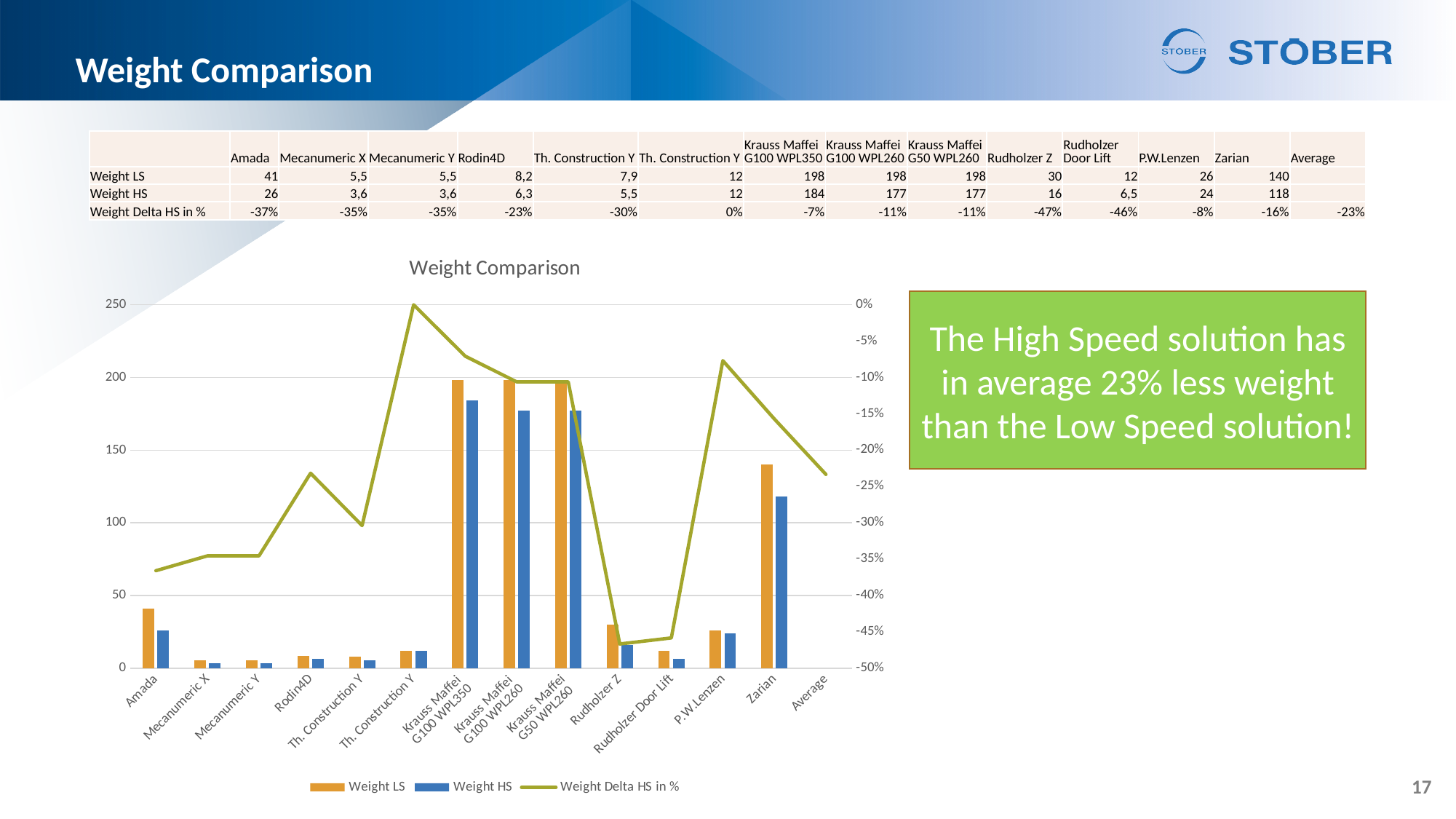
What is the Average value of Weight Delta HS in %? -23% Which is larger, the Weight LS for Amada or the Weight LS for Zarian? Zarian What kind of chart is shown on the slide? bar chart with a line What is the Weight Delta HS in % for Rudholzer Z? -47% How many categories are shown on the x axis of the chart? 14 How many series does the chart legend list? 3 What is the difference between Weight LS and Weight HS for Zarian? 22 What is the Weight HS value for Zarian? 118 What is the Weight LS value for Amada? 41 Is the Weight LS value for Rudholzer Z greater or less than 50? less Which category has the highest Weight Delta HS in %? Th. Construction Y What is the difference between Weight LS and Weight HS for Amada? 15